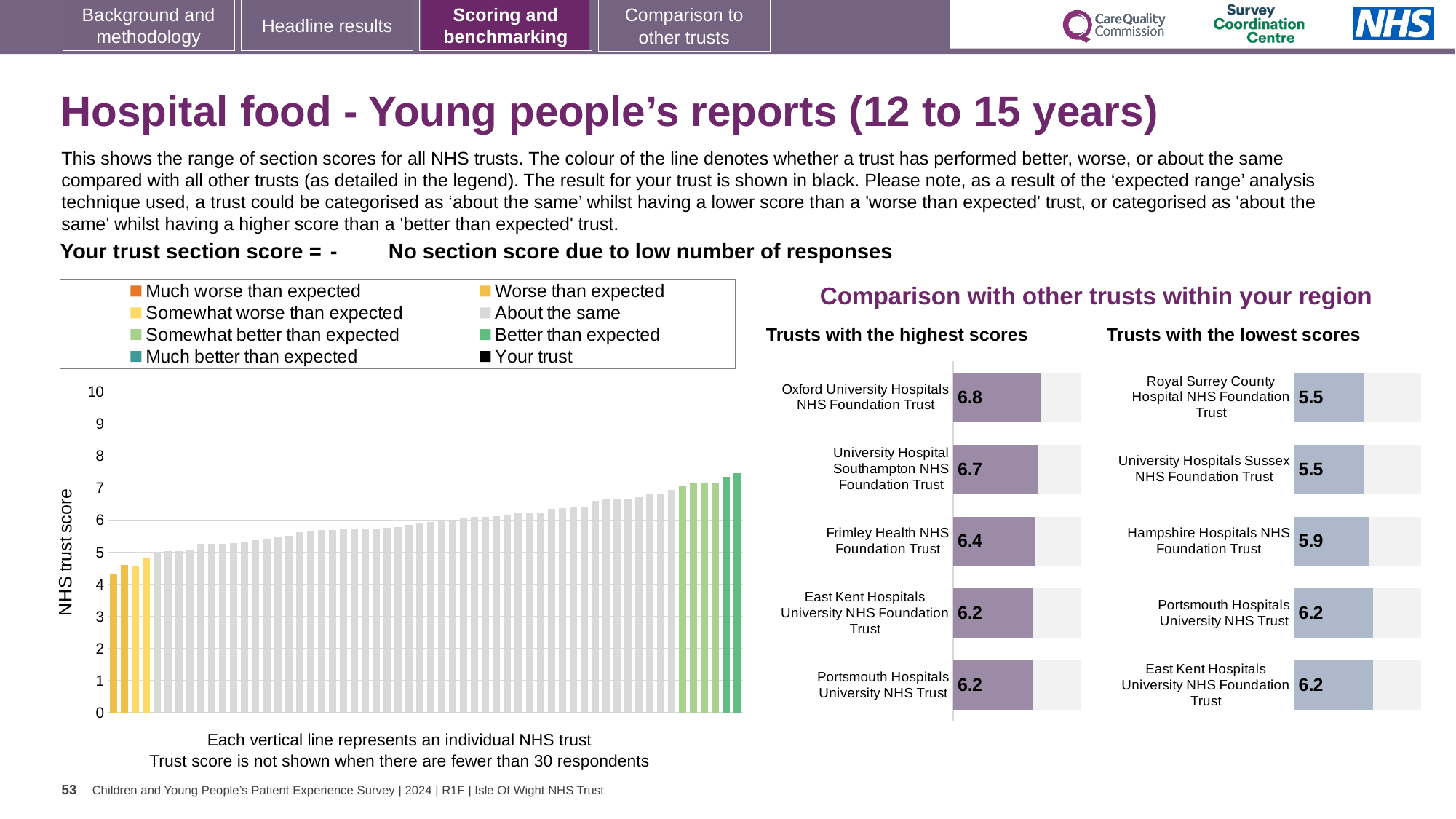
In the large chart on the left, do the trust scores rise or fall from left to right? Rise In the 'Trusts with the highest scores' chart, what is the difference between the scores of Oxford University Hospitals NHS Foundation Trust and Frimley Health NHS Foundation Trust? 0.4 In the 'Trusts with the highest scores' chart, what is the score for Oxford University Hospitals NHS Foundation Trust? 6.8 In the 'Trusts with the lowest scores' chart, what is the difference between the scores of Portsmouth Hospitals University NHS Trust and University Hospitals Sussex NHS Foundation Trust? 0.7 What kind of chart is the large chart on the left with the 'NHS trust score' axis? Bar chart In the 'Trusts with the lowest scores' chart, what is the score for Royal Surrey County Hospital NHS Foundation Trust? 5.5 In the 'Trusts with the highest scores' chart, what is the score for Frimley Health NHS Foundation Trust? 6.4 In the 'Trusts with the lowest scores' chart, which is larger: the score for Hampshire Hospitals NHS Foundation Trust or Royal Surrey County Hospital NHS Foundation Trust? Hampshire Hospitals NHS Foundation Trust In the 'Trusts with the lowest scores' chart, what is the score for Hampshire Hospitals NHS Foundation Trust? 5.9 How many trusts are shown in the 'Trusts with the highest scores' chart? 5 In the 'Trusts with the highest scores' chart, which trust has the highest score? Oxford University Hospitals NHS Foundation Trust How many entries does the legend above the large chart on the left list? 8